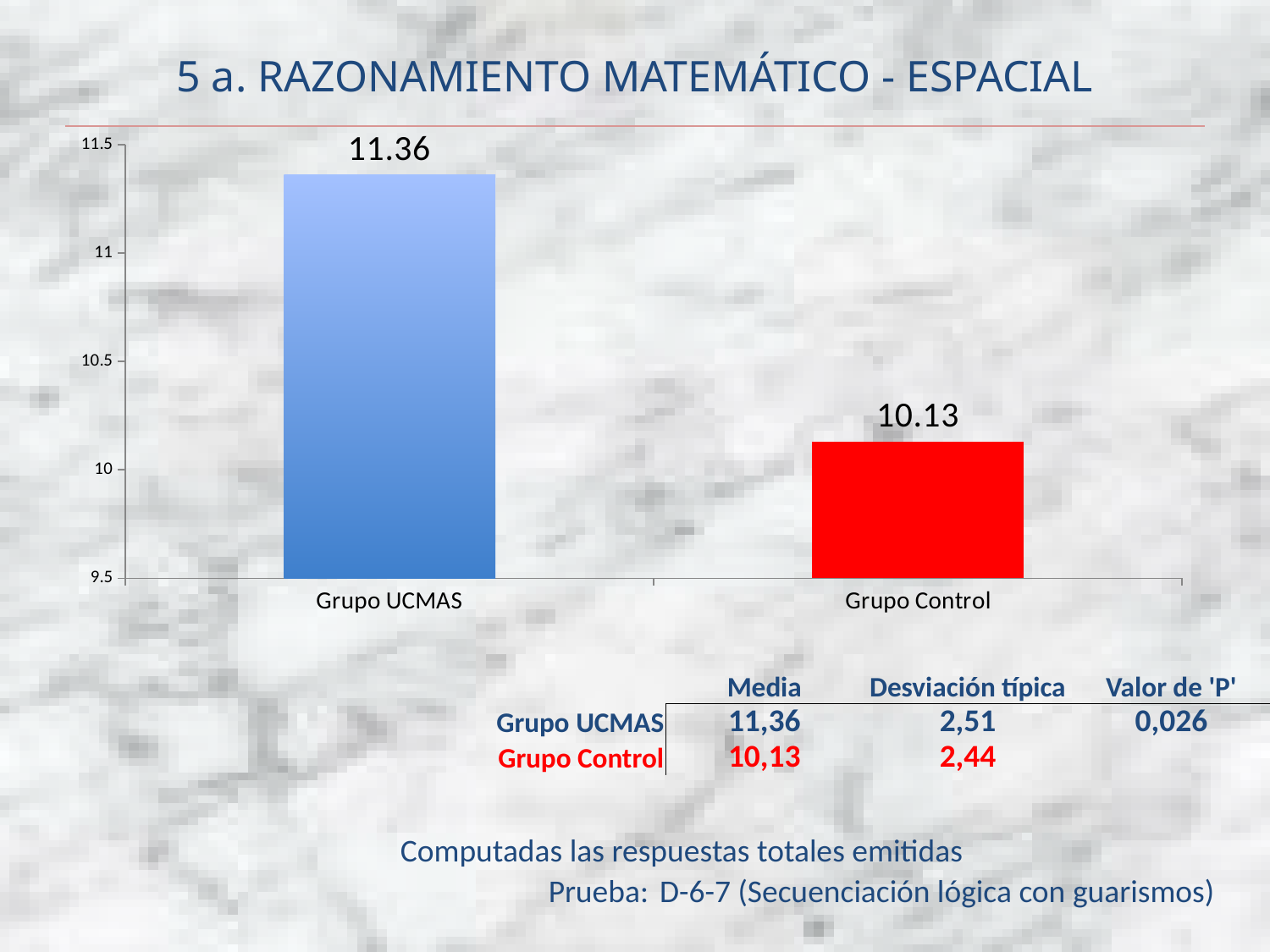
What is the difference between the values for Grupo UCMAS and Grupo Control? 1.23 What kind of chart is shown on the slide? bar chart What is the value for Grupo Control? 10.13 What is the title of the slide containing the chart? 5 a. RAZONAMIENTO MATEMÁTICO - ESPACIAL How many categories are shown in the chart? 2 What is the value for Grupo UCMAS? 11.36 Is the value for Grupo Control greater or less than 10.5? less What colour is the bar for Grupo Control? red Which is larger, the value for Grupo UCMAS or the value for Grupo Control? Grupo UCMAS Which category has the lowest value? Grupo Control Which category has the highest value? Grupo UCMAS Is the value for Grupo UCMAS greater or less than 11? greater